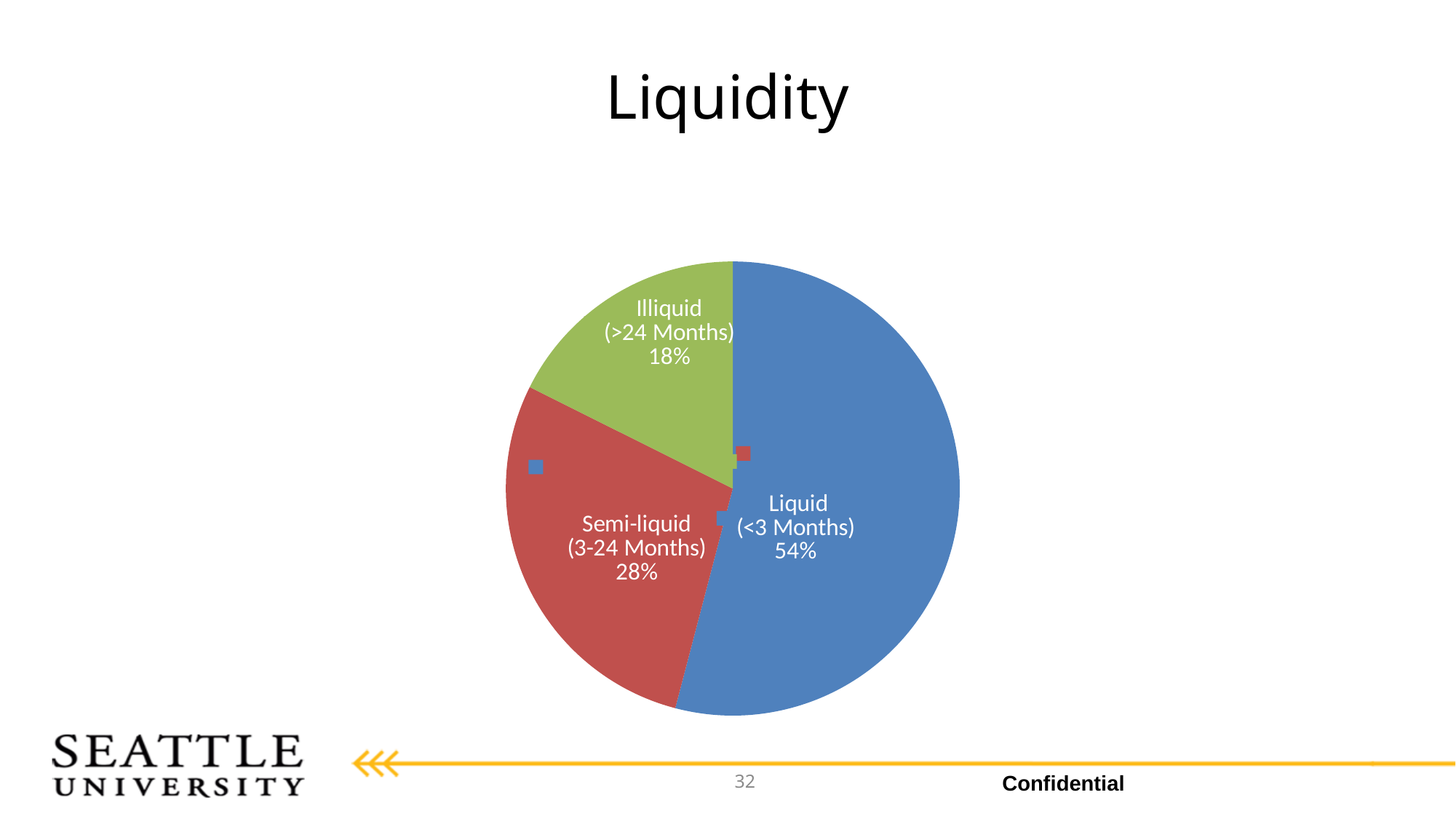
How many slices does the pie chart have? 3 Which is larger, the Semi-liquid (3-24 Months) slice or the Illiquid (>24 Months) slice? Semi-liquid (3-24 Months) What share of the pie is Semi-liquid (3-24 Months)? 28% Which category has the smallest slice of the pie? Illiquid (>24 Months) What colour is the Liquid (<3 Months) slice? blue What is the difference in percentage points between the Liquid (<3 Months) and Semi-liquid (3-24 Months) slices? 26 What kind of chart is shown on the slide? pie chart What is the title of the slide containing the pie chart? Liquidity What share of the pie is Illiquid (>24 Months)? 18% What is the difference in percentage points between the Semi-liquid (3-24 Months) and Illiquid (>24 Months) slices? 10 What share of the pie is Liquid (<3 Months)? 54% Which category has the largest slice of the pie? Liquid (<3 Months)